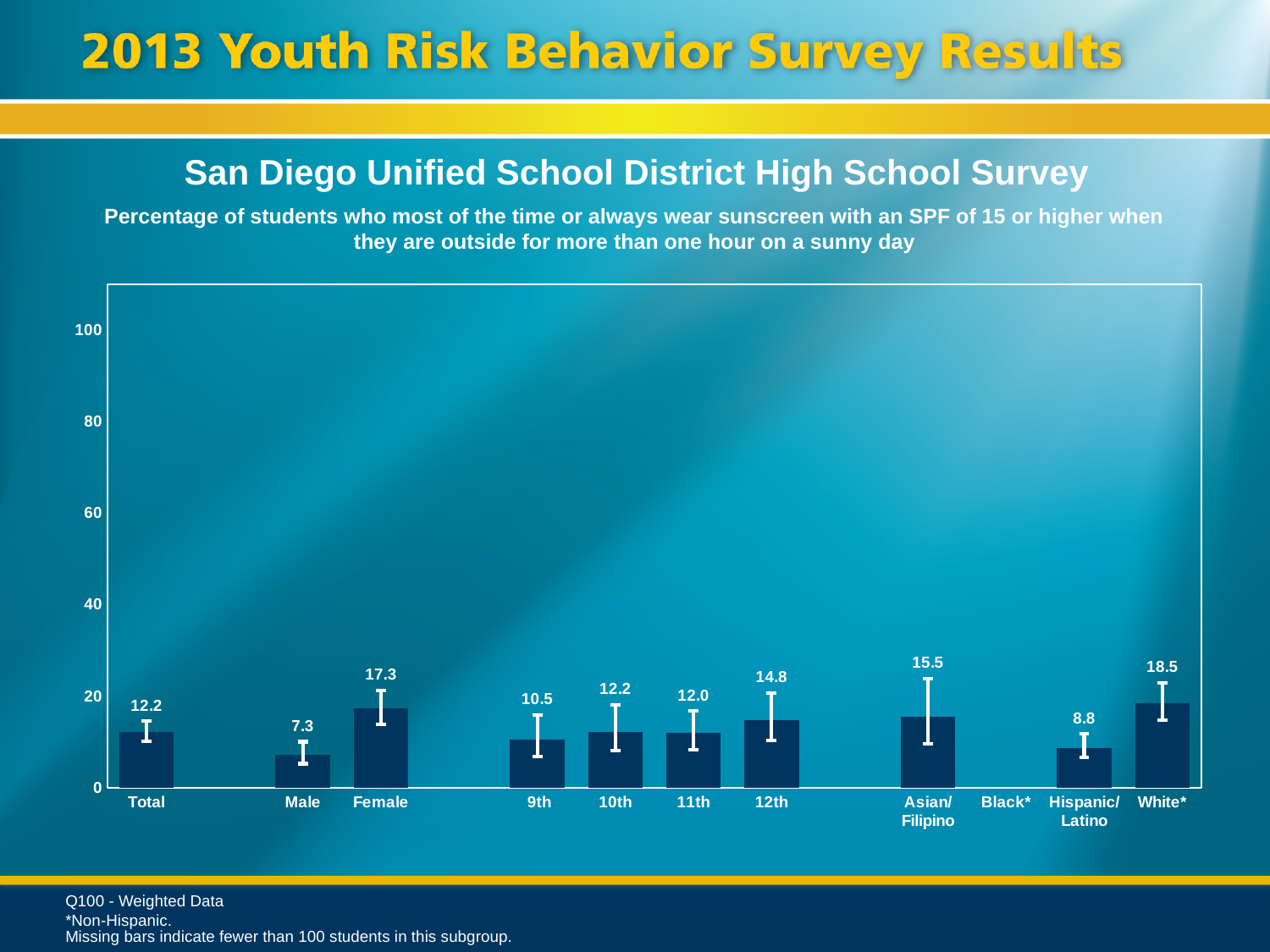
Which category label has no bar plotted? Black* Do the values rise or fall from 9th to 12th grade? rise What is the value for Total? 12.2 What is the difference between the Female and Male values? 10.0 How many categories have a plotted bar? 10 What kind of chart is shown? bar chart What is the value for Hispanic/Latino? 8.8 Is the value for Asian/Filipino greater or less than 20? less What is the value for Female? 17.3 Which is larger, the value for 12th or the value for 9th? 12th Which category has the lowest plotted value? Male Which category has the highest value? White*